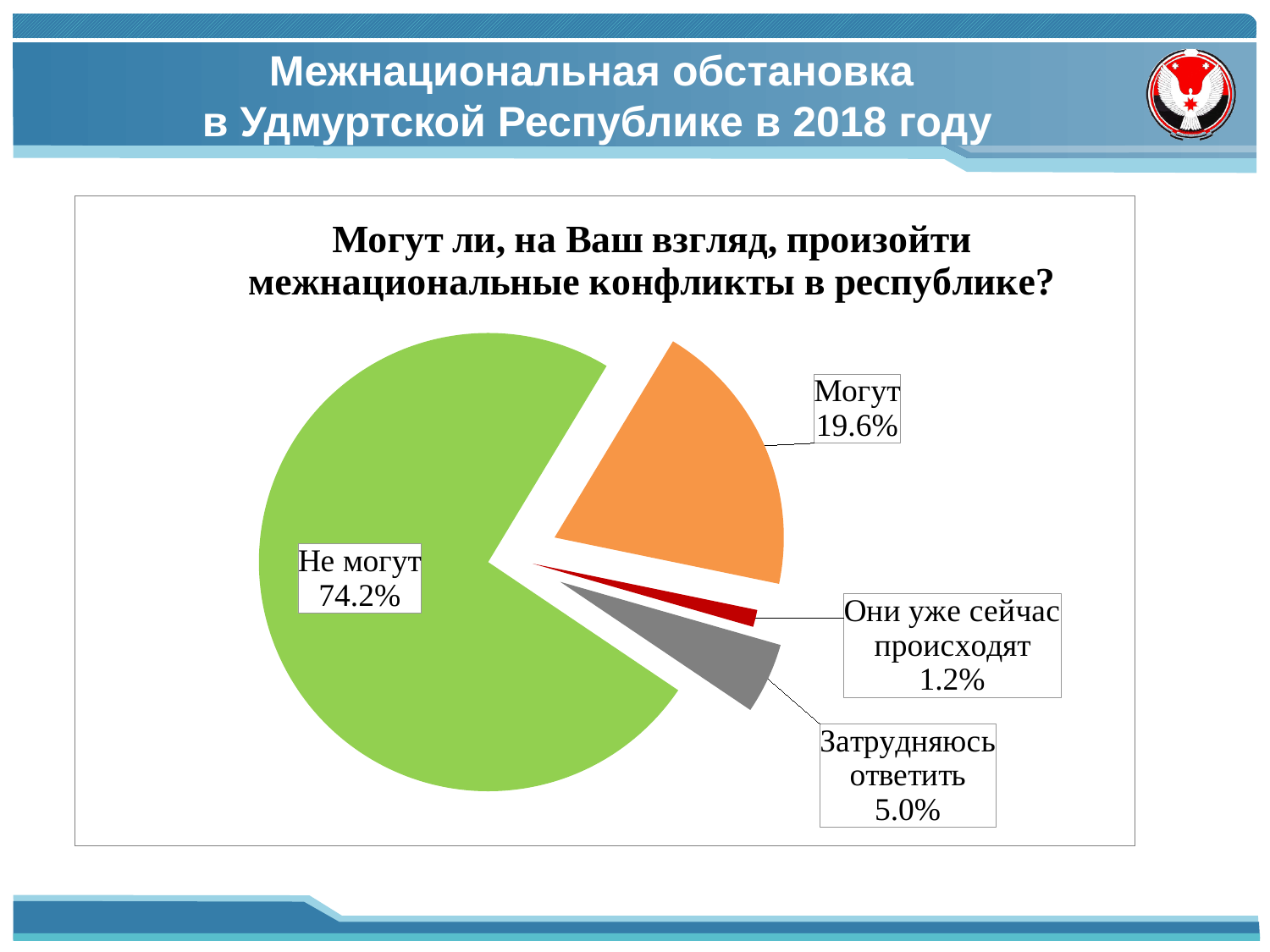
Which answer option has the smallest share of the pie? Они уже сейчас происходят Which is larger: the share for "Затрудняюсь ответить" or for "Они уже сейчас происходят"? Затрудняюсь ответить What kind of chart is shown on the slide? pie chart What share of respondents answered "Не могут"? 74.2% What share of respondents answered "Затрудняюсь ответить"? 5.0% What is the difference in percentage points between "Не могут" and "Могут"? 54.6 What share of respondents answered "Они уже сейчас происходят"? 1.2% What is the title of the pie chart? Могут ли, на Ваш взгляд, произойти межнациональные конфликты в республике? How many slices does the pie chart have? 4 What colour is the slice for "Могут"? orange Which answer option has the largest share of the pie? Не могут What share of respondents answered "Могут"? 19.6%